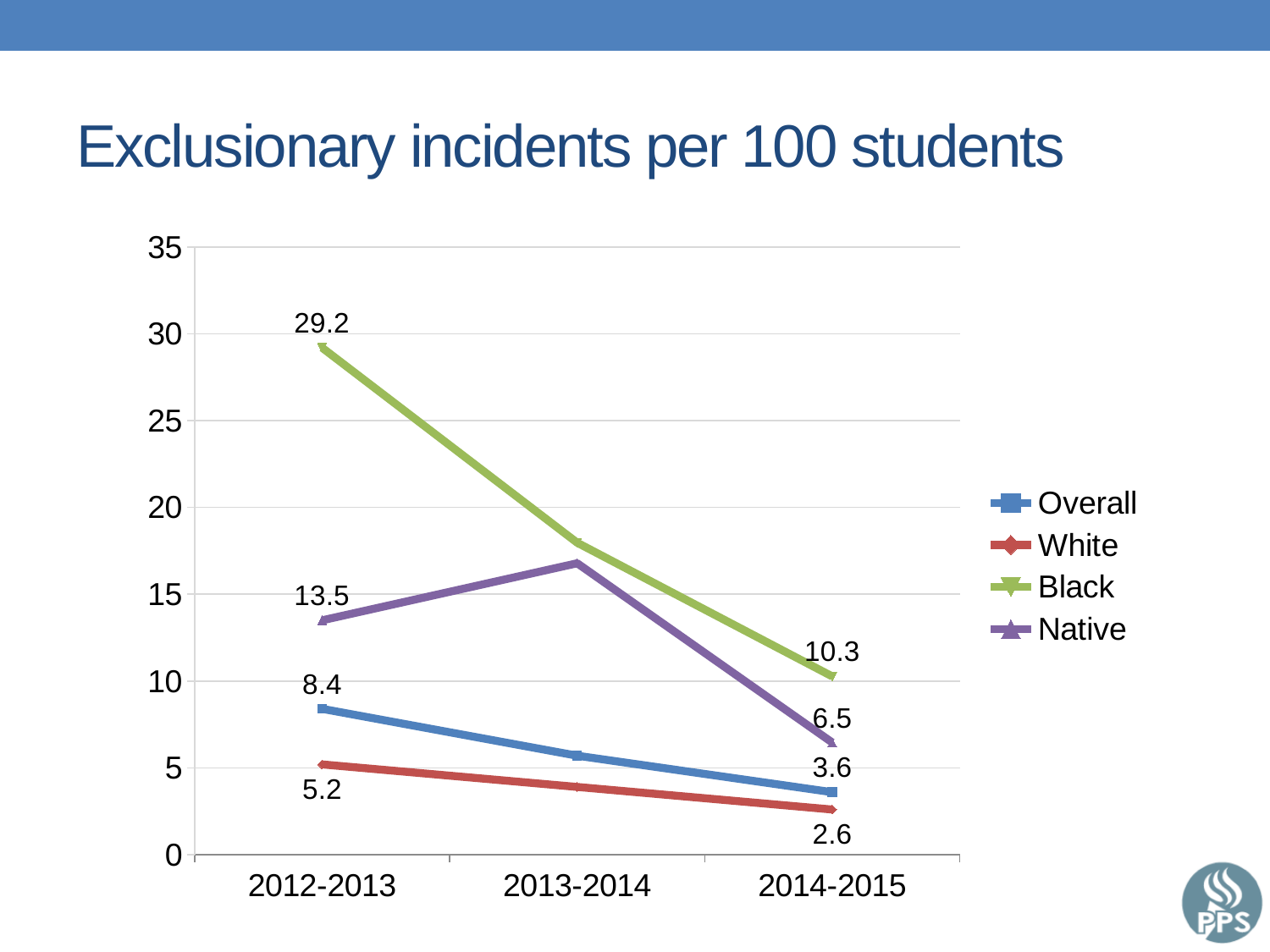
What is the value for Native in 2014-2015? 6.5 What is the value for White in 2012-2013? 5.2 Which series has the highest value in 2012-2013? Black What is the value for Overall in 2014-2015? 3.6 What kind of chart is shown on the slide? line chart What is the value for Black in 2012-2013? 29.2 How many series does the legend list? 4 Which is larger in 2014-2015, the value for Native or the value for Overall? Native Is the value for Native in 2013-2014 greater or less than 15? greater By how much did the Black value fall from 2012-2013 to 2014-2015? 18.9 Does the Black series rise or fall from 2012-2013 to 2014-2015? fall Which series has the lowest value in 2014-2015? White